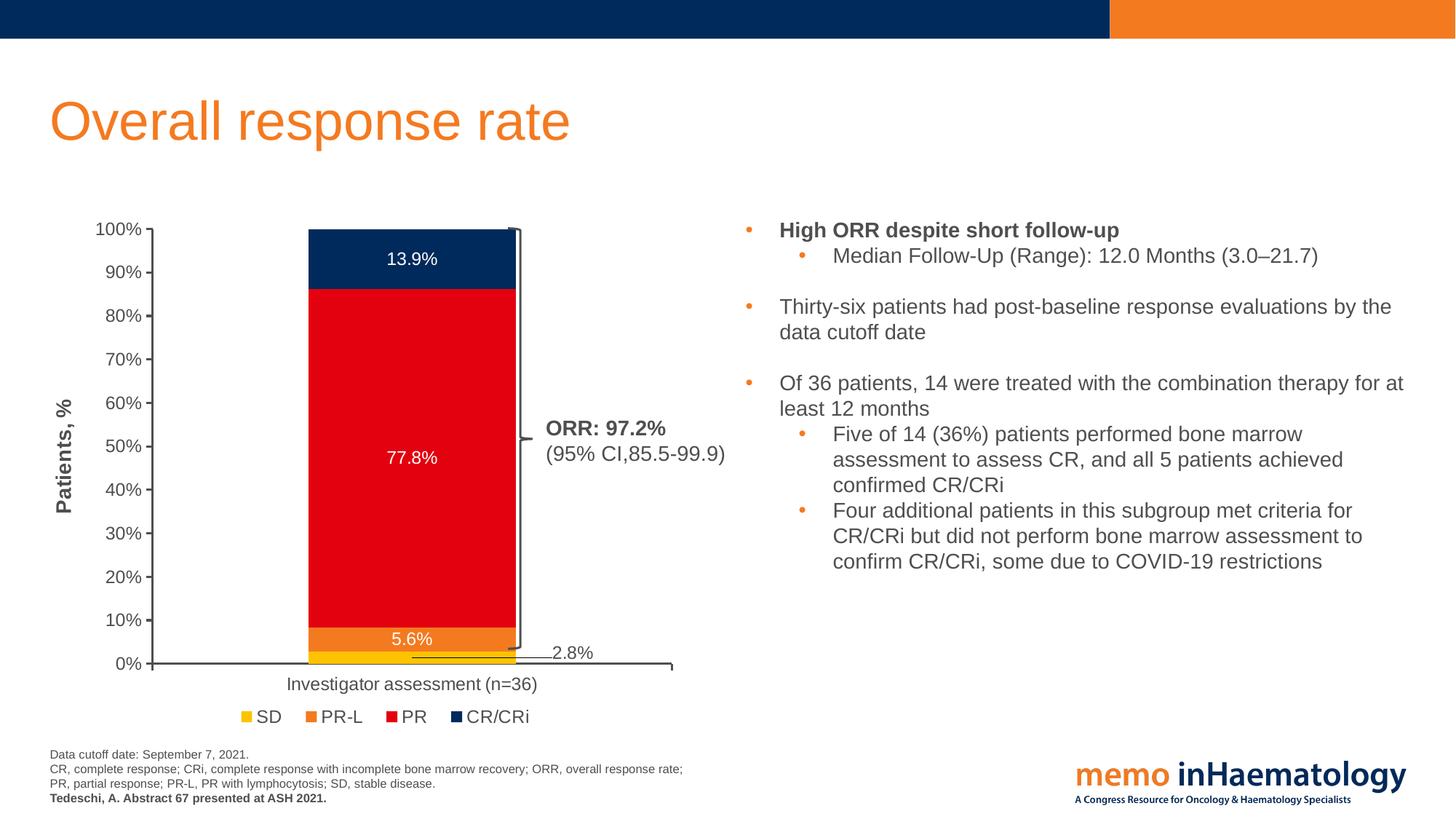
What percentage of patients achieved PR in the investigator assessment? 77.8% Which response category has the largest share of patients? PR What kind of chart is shown on the slide? Stacked bar chart What percentage of patients achieved CR/CRi? 13.9% What percentage of patients had SD (stable disease)? 2.8% What percentage of patients had PR-L? 5.6% What is the difference between the PR and CR/CRi percentages? 63.9% What ORR value is annotated next to the bar? 97.2% What is the label of the y axis? Patients, % Which is larger, the CR/CRi percentage or the PR-L percentage? CR/CRi Which response category has the smallest share of patients? SD How many series does the legend list? 4